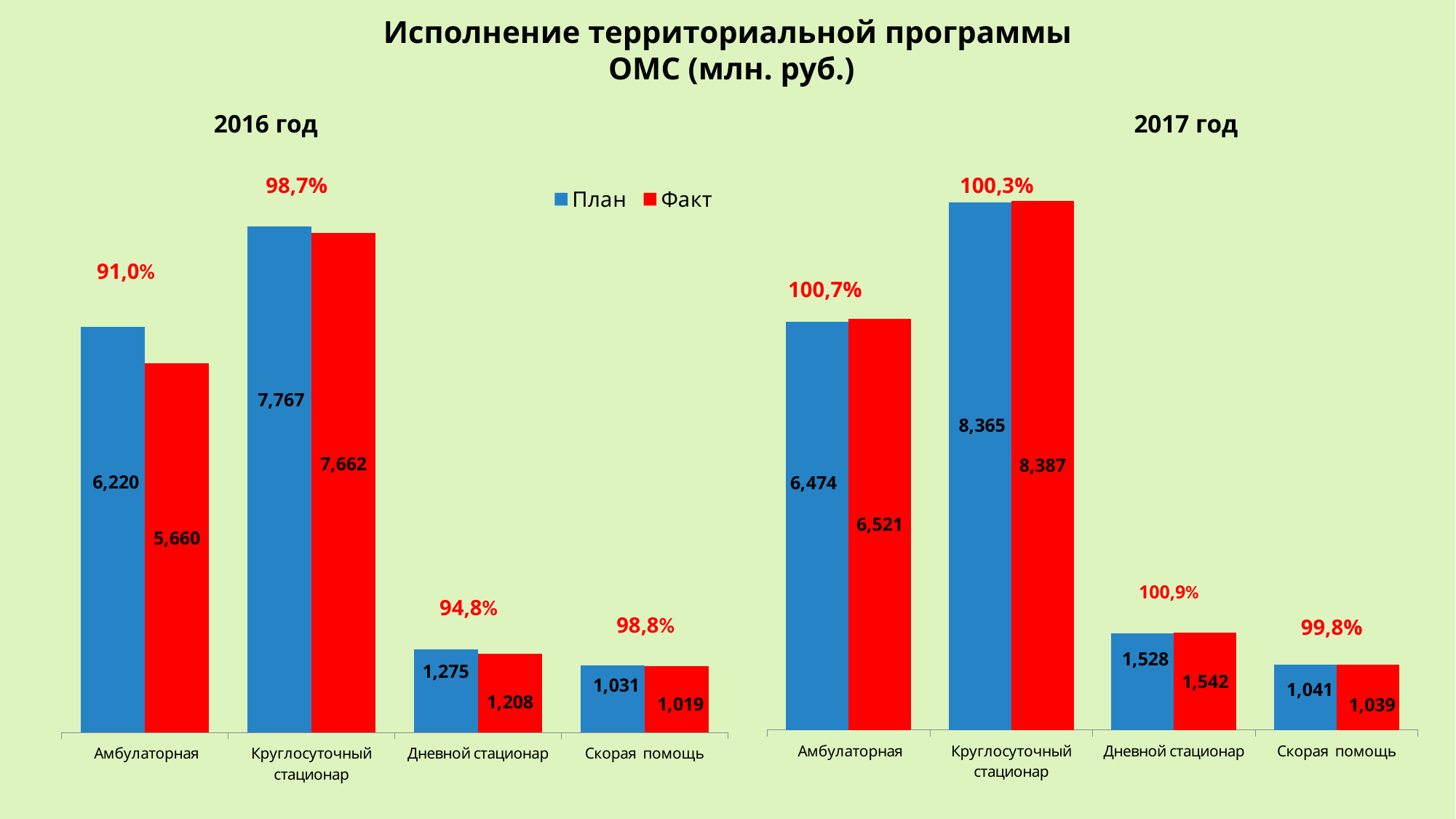
In the 2016 год chart, what is the Факт value for Дневной стационар? 1,208 In the 2017 год chart, which is larger for Амбулаторная, План or Факт? Факт In the 2016 год chart, which category has the highest Факт value? Круглосуточный стационар What percentage is shown above the Дневной стационар bars in the 2017 год chart? 100,9% In the 2017 год chart, which category has the lowest План value? Скорая помощь In the 2017 год chart, what is the План value for Скорая помощь? 1,041 In the 2016 год chart, what is the План value for Амбулаторная? 6,220 In the 2017 год chart, what is the Факт value for Круглосуточный стационар? 8,387 How many categories are shown on the x axis of the 2016 год chart? 4 In the 2017 год chart, what is the difference between the Факт and План values for Круглосуточный стационар? 22 In the 2016 год chart, what is the difference between the План and Факт values for Амбулаторная? 560 How many series does the legend list? 2